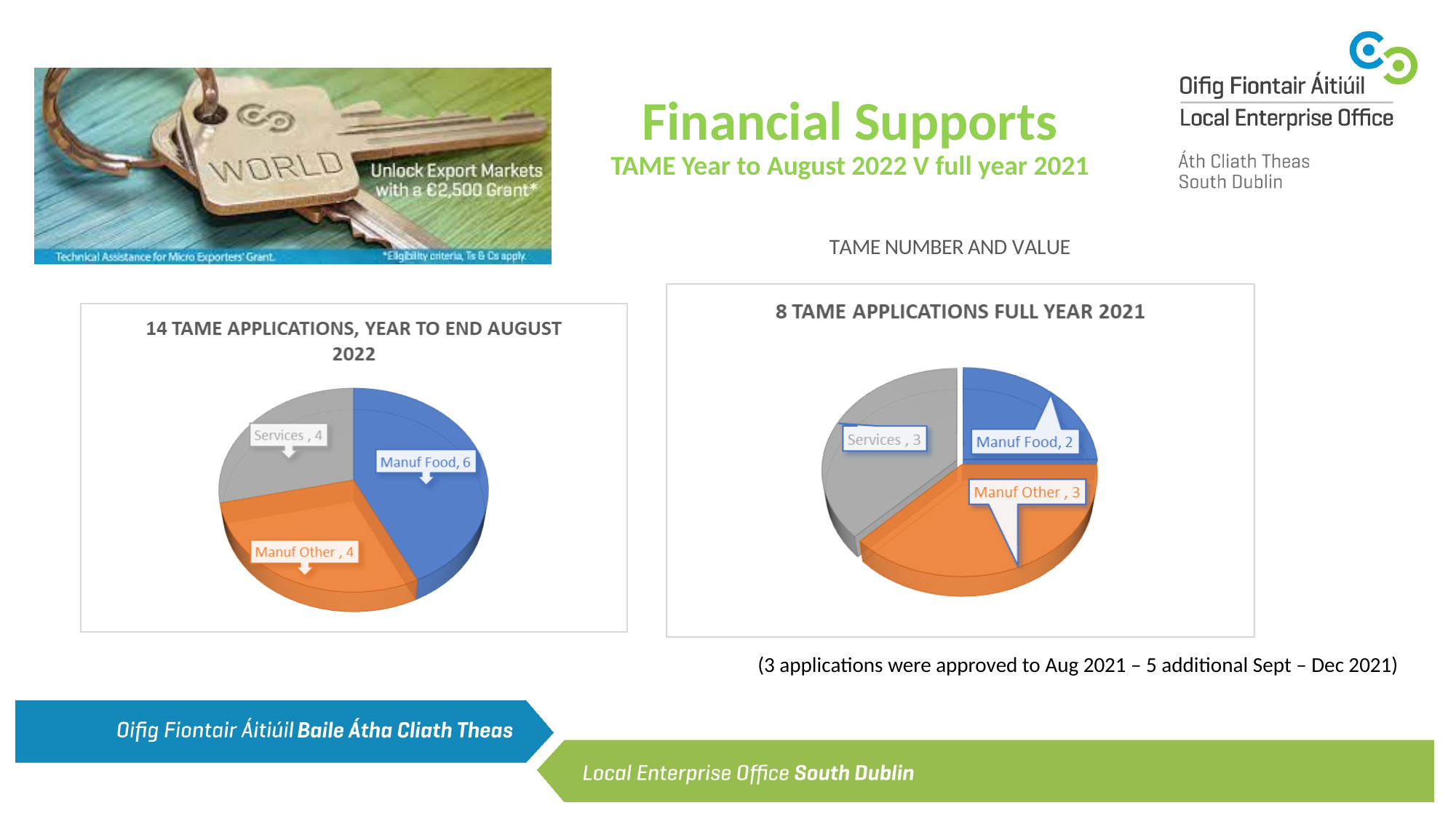
In the '14 TAME APPLICATIONS, YEAR TO END AUGUST 2022' chart, what colour is the Manuf Other slice? Orange In the '14 TAME APPLICATIONS, YEAR TO END AUGUST 2022' chart, how many applications are for Manuf Food? 6 What type of chart is used for '14 TAME APPLICATIONS, YEAR TO END AUGUST 2022'? Pie chart How many categories are shown in the '8 TAME APPLICATIONS FULL YEAR 2021' chart? 3 In the '14 TAME APPLICATIONS, YEAR TO END AUGUST 2022' chart, what is the difference between Manuf Food and Services? 2 In the '8 TAME APPLICATIONS FULL YEAR 2021' chart, how many applications are for Manuf Food? 2 Which chart has a larger value for Manuf Food: the 2022 year-to-August chart or the full year 2021 chart? The 2022 year-to-August chart In the '14 TAME APPLICATIONS, YEAR TO END AUGUST 2022' chart, which category has the largest slice? Manuf Food In the '8 TAME APPLICATIONS FULL YEAR 2021' chart, what share of the total does Manuf Food represent? 25% In the '14 TAME APPLICATIONS, YEAR TO END AUGUST 2022' chart, what is the value for Services? 4 In the '8 TAME APPLICATIONS FULL YEAR 2021' chart, what is the value for Manuf Other? 3 In the '8 TAME APPLICATIONS FULL YEAR 2021' chart, which category has the smallest slice? Manuf Food